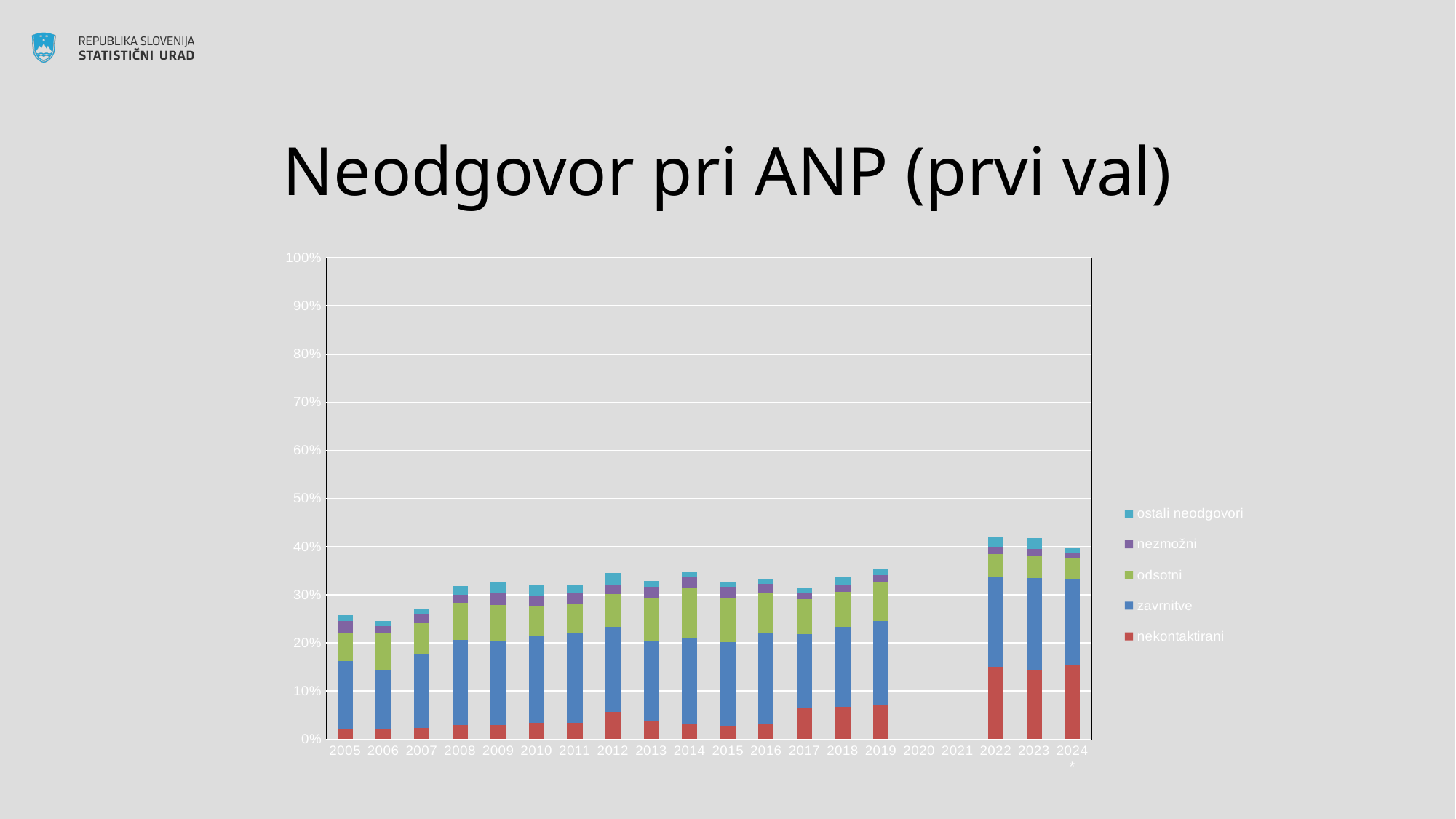
Which year has the larger nekontaktirani value, 2019 or 2023? 2023 Do the stacked bar totals rise or fall from 2022 to 2024? fall Is the total of the stacked bar for 2019 greater or less than 30%? greater What is the title of the chart? Neodgovor pri ANP (prvi val) How many series does the legend list? 5 Is the total of the stacked bar for 2022 greater or less than 40%? greater How many years have a bar plotted in the chart? 18 Is the total of the stacked bar for 2005 greater or less than 30%? less Which years on the x axis have no bar plotted? 2020 and 2021 Which has the larger total non-response, 2022 or 2005? 2022 What kind of chart is shown on the slide? stacked bar chart